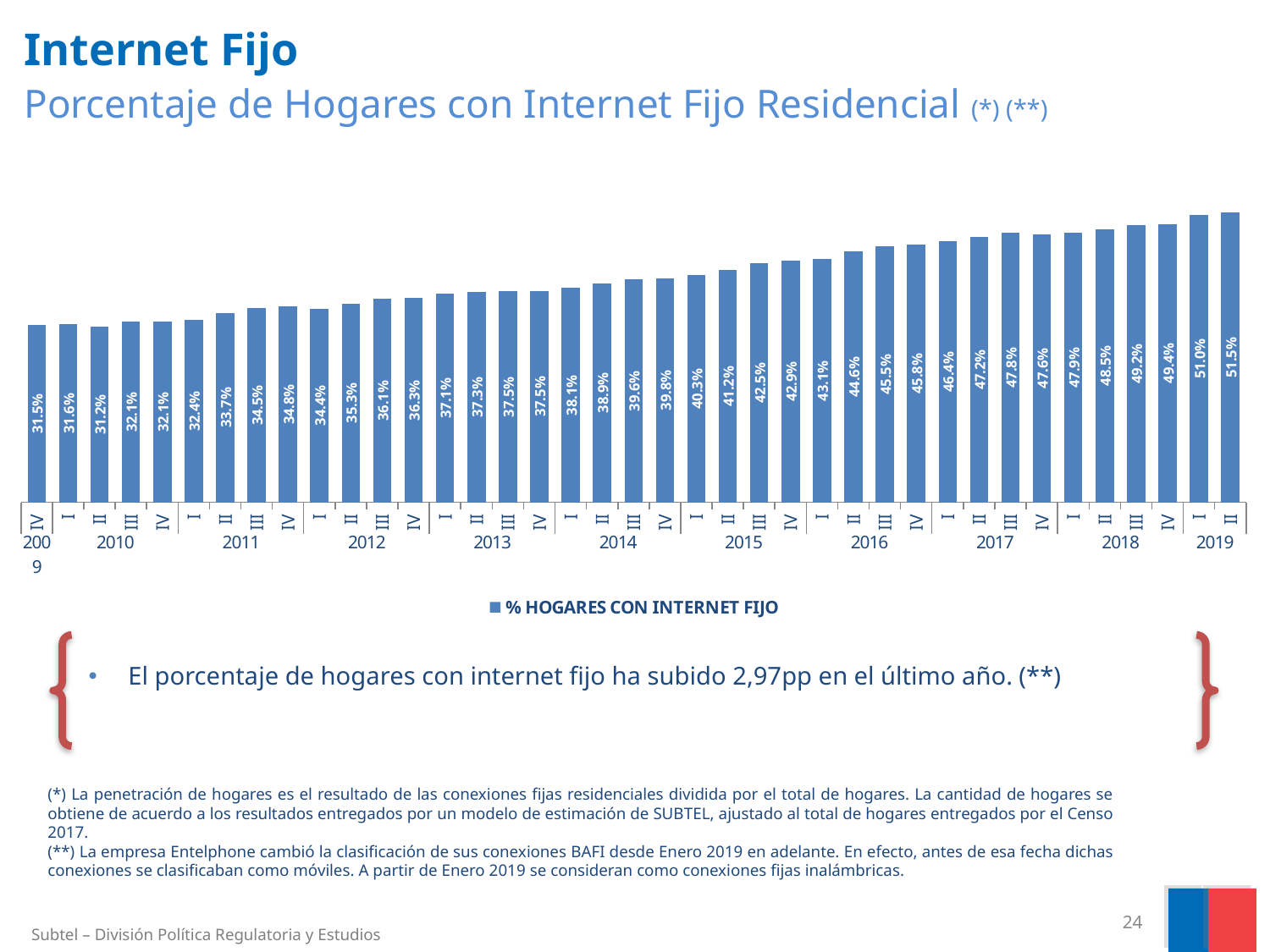
Do the values generally rise or fall from 2009 to 2019? Rise What is the value shown for quarter IV of 2009? 31.5% What is the value shown for quarter I of 2015? 40.3% How many series does the legend list? 1 Which is larger, the value for quarter III of 2017 or the value for quarter IV of 2017? III 2017 Which quarter has the highest percentage of households with fixed internet? II 2019 What is the legend entry for the series in the chart? % HOGARES CON INTERNET FIJO What type of chart is shown on the slide? Bar chart What is the percentage of households with fixed internet in quarter II of 2019? 51.5% How many bars (quarters) are plotted in the chart? 39 Which quarter has the lowest percentage of households with fixed internet? II 2010 What is the difference between the values for quarter II of 2019 and quarter II of 2018? 3.0 percentage points